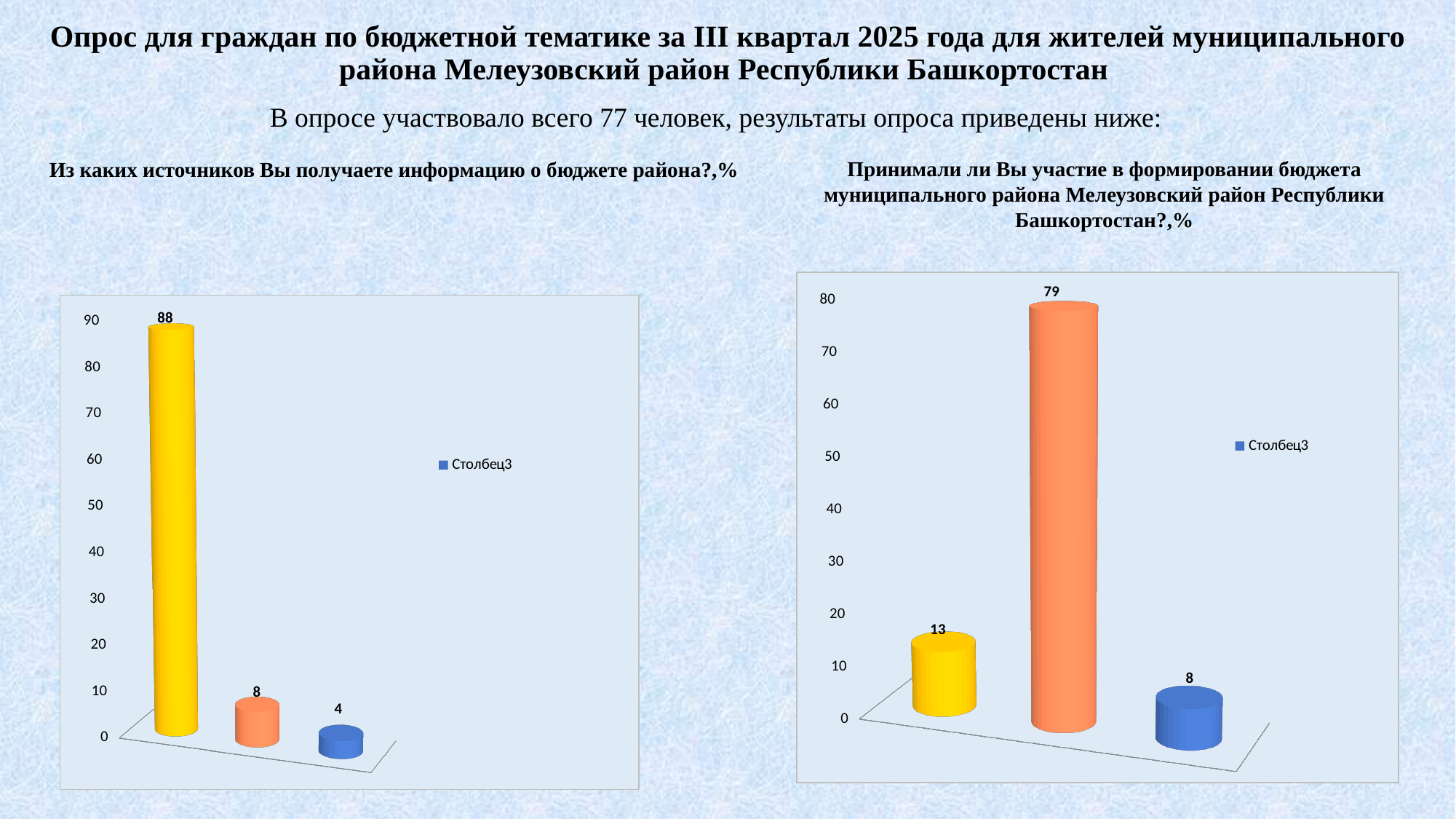
In the right chart ("Принимали ли Вы участие в формировании бюджета...?,%"), what is the lowest value shown? 8 In the right chart ("Принимали ли Вы участие в формировании бюджета...?,%"), what is the value of the yellow bar? 13 In the right chart ("Принимали ли Вы участие в формировании бюджета...?,%"), what is the difference between the orange bar and the yellow bar? 66 In the left chart ("Из каких источников Вы получаете информацию о бюджете района?,%"), what is the value of the tallest yellow bar? 88 In the left chart ("Из каких источников Вы получаете информацию о бюджете района?,%"), what is the value of the orange bar? 8 In the left chart ("Из каких источников Вы получаете информацию о бюджете района?,%"), what is the value of the blue bar? 4 In the right chart ("Принимали ли Вы участие в формировании бюджета...?,%"), which is larger, the yellow bar or the blue bar? the yellow bar In the left chart ("Из каких источников Вы получаете информацию о бюджете района?,%"), how many bars are plotted? 3 What type of chart is the right chart ("Принимали ли Вы участие в формировании бюджета...?,%")? bar chart In the right chart ("Принимали ли Вы участие в формировании бюджета...?,%"), what is the value of the orange bar? 79 In the left chart ("Из каких источников Вы получаете информацию о бюджете района?,%"), what is the difference between the yellow bar and the orange bar? 80 In the left chart ("Из каких источников Вы получаете информацию о бюджете района?,%"), what is the highest value shown? 88